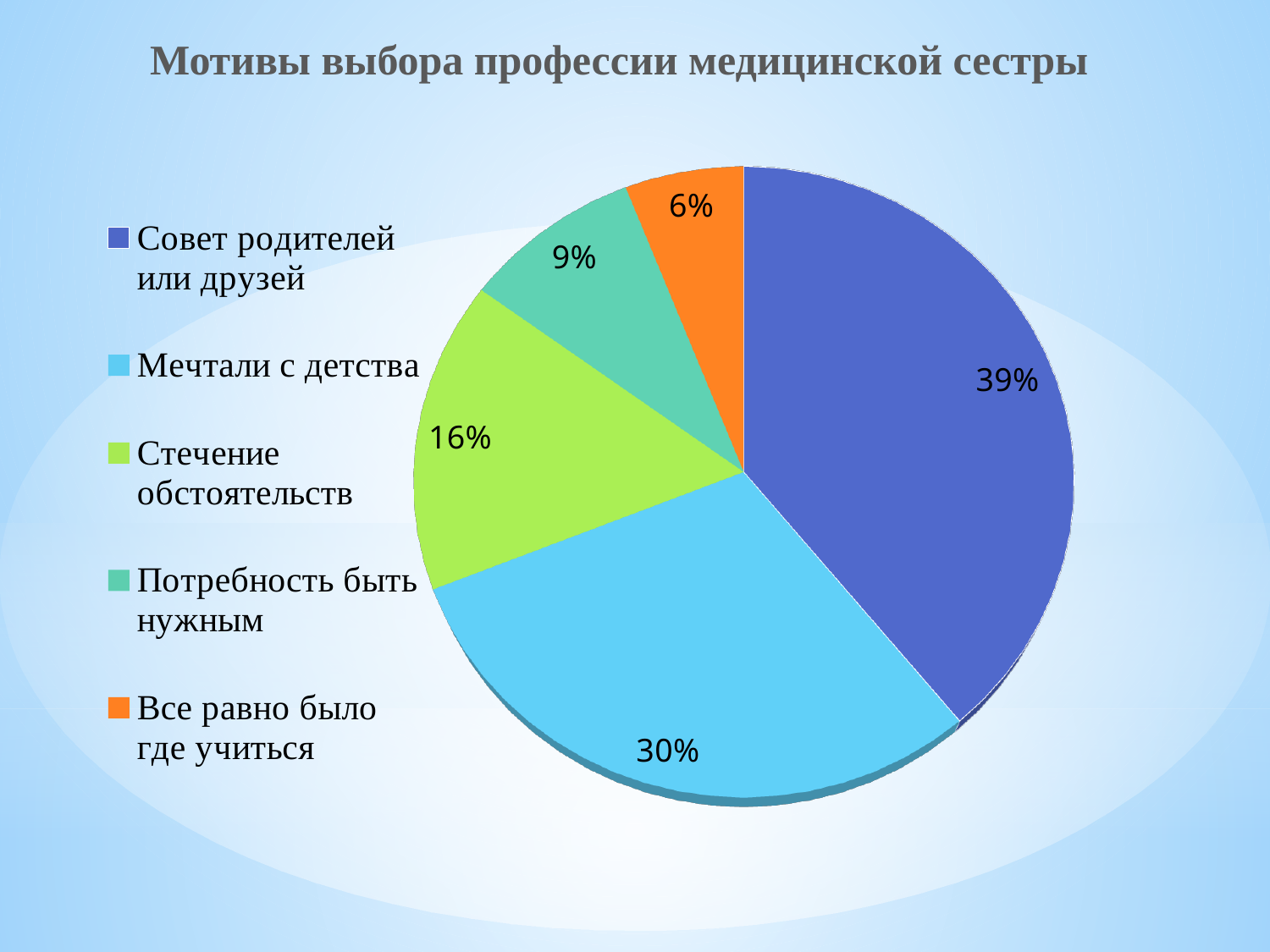
What share of the pie is labelled for "Все равно было где учиться"? 6% How many categories does the legend list? 5 Which category has the smallest slice of the pie? Все равно было где учиться Which is larger: the share for "Стечение обстоятельств" or the share for "Потребность быть нужным"? Стечение обстоятельств What is the title of the chart? Мотивы выбора профессии медицинской сестры What share of the pie is labelled for "Стечение обстоятельств"? 16% What share of the pie is labelled for "Совет родителей или друзей"? 39% What kind of chart is shown on the slide? Pie chart What share of the pie is labelled for "Мечтали с детства"? 30% Which category has the largest slice of the pie? Совет родителей или друзей What share of the pie is labelled for "Потребность быть нужным"? 9% What is the difference between the shares for "Совет родителей или друзей" and "Мечтали с детства"? 9%